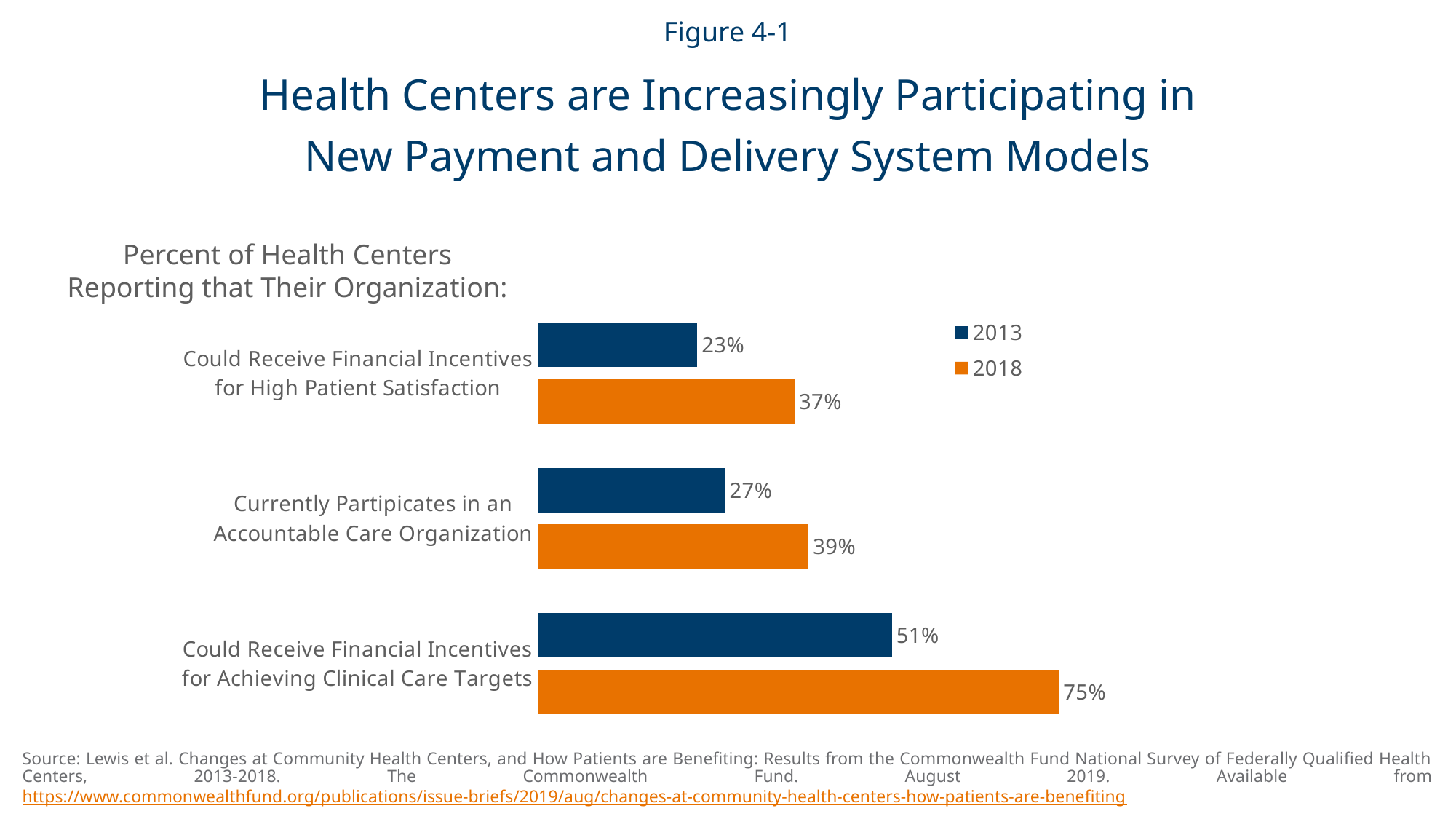
Which is larger: the 2013 value for Currently Participates in an Accountable Care Organization or the 2013 value for Could Receive Financial Incentives for High Patient Satisfaction? Currently Participates in an Accountable Care Organization How many categories are shown on the chart? 3 What percent of health centers reported in 2018 that they currently participate in an Accountable Care Organization? 39% How many series does the legend list? 2 What kind of chart is shown on the slide? Bar chart What is the difference between the 2018 and 2013 values for Could Receive Financial Incentives for Achieving Clinical Care Targets? 24 percentage points What percent of health centers reported in 2013 that they could receive financial incentives for high patient satisfaction? 23% Which category has the lowest value for 2013? Could Receive Financial Incentives for High Patient Satisfaction Which colour represents the 2018 series in the chart? Orange Which category has the highest value for 2018? Could Receive Financial Incentives for Achieving Clinical Care Targets What is the difference between the 2018 and 2013 values for Currently Participates in an Accountable Care Organization? 12 percentage points What percent of health centers reported in 2018 that they could receive financial incentives for achieving clinical care targets? 75%